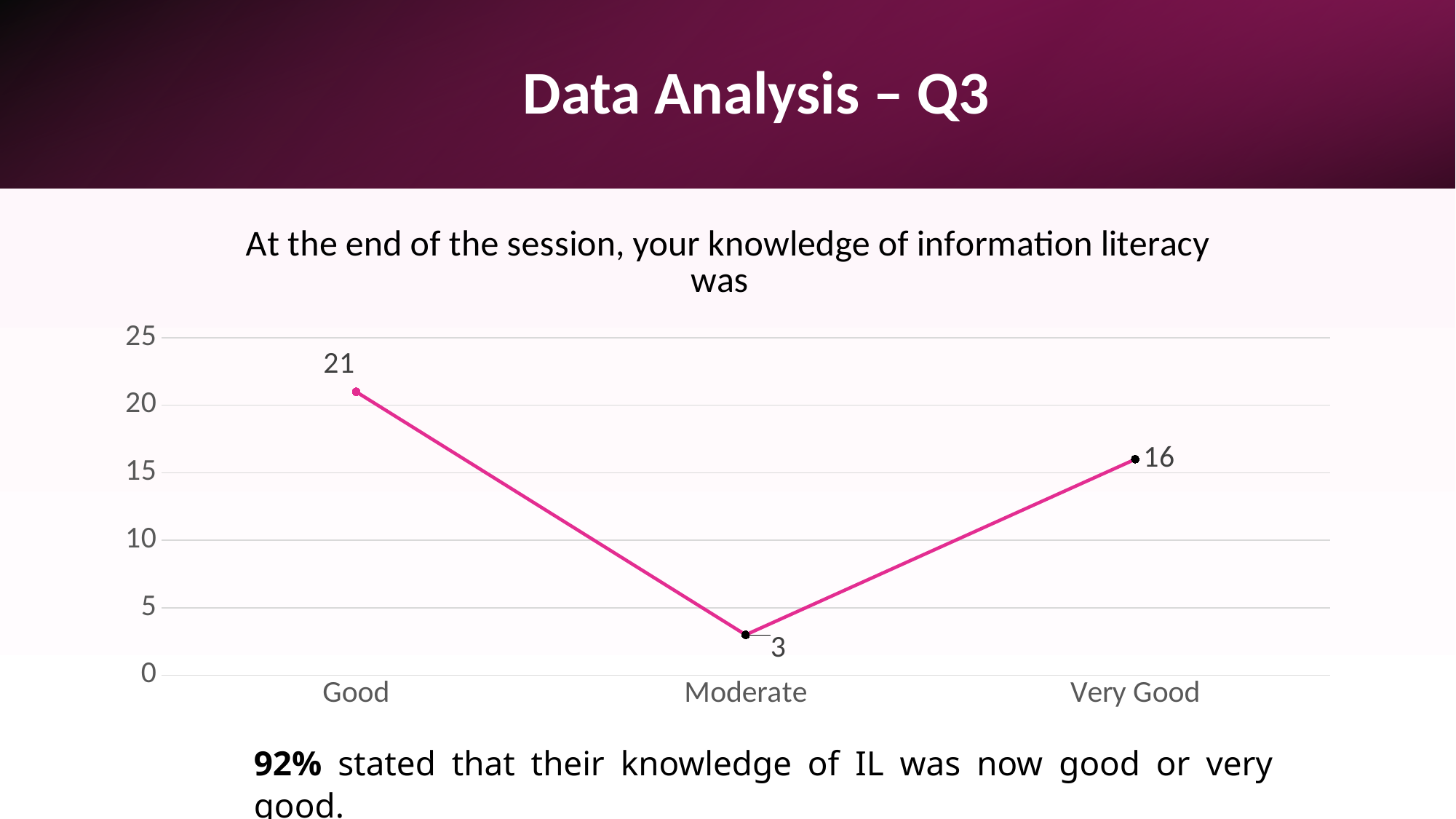
What is the title of the chart? At the end of the session, your knowledge of information literacy was What is the value for Good? 21 Which category has the lowest value? Moderate What kind of chart is shown on the slide? line chart Which category has the highest value? Good Is the value for Very Good greater or less than 15? greater What is the difference between the values for Good and Very Good? 5 What is the difference between the values for Very Good and Moderate? 13 Which is larger, the value for Good or the value for Very Good? Good How many categories are shown on the x axis? 3 What is the value for Moderate? 3 What is the value for Very Good? 16